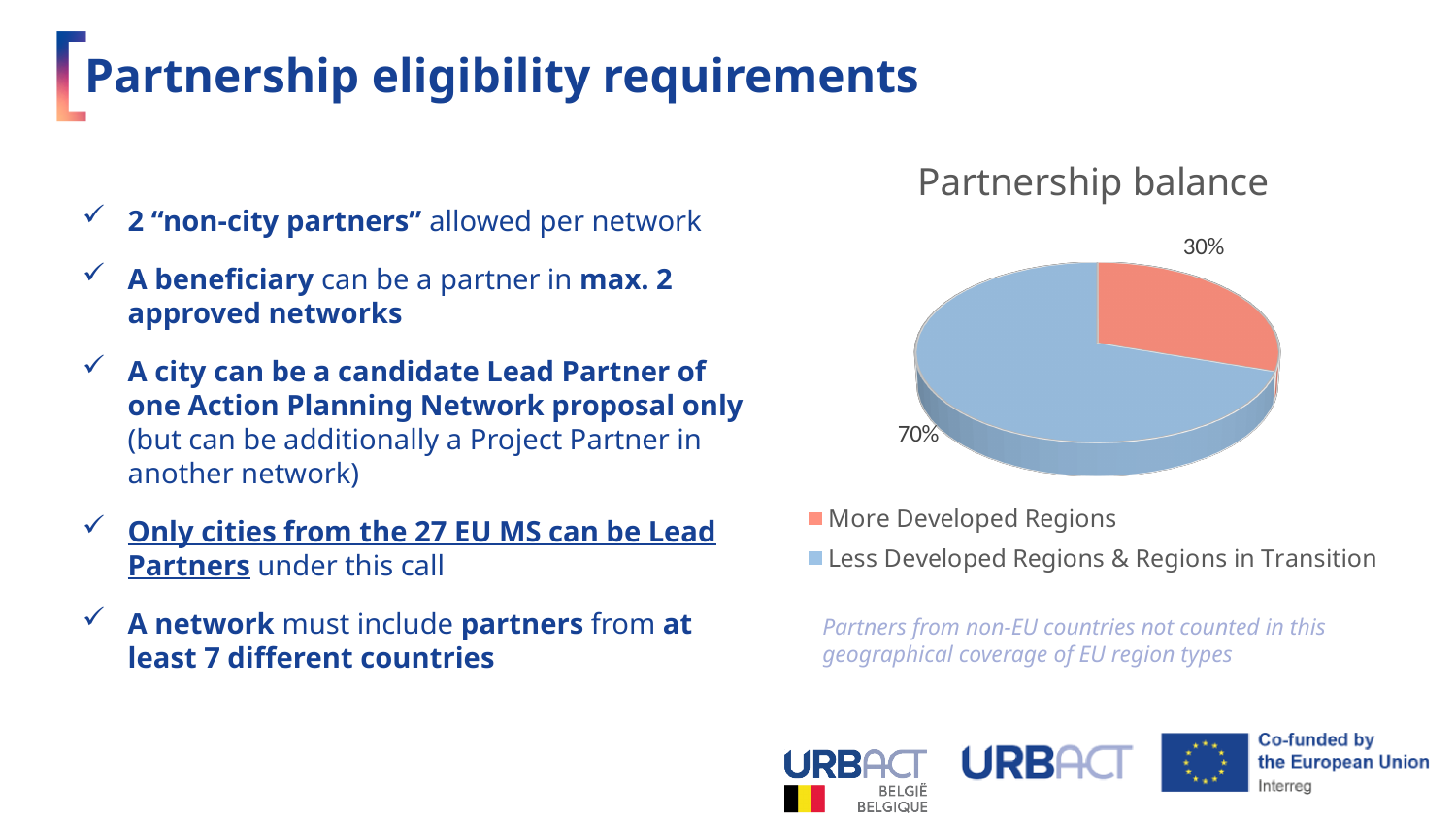
What kind of chart is shown on the slide? pie chart Which category has the smallest slice of the pie? More Developed Regions Which slice is larger: More Developed Regions or Less Developed Regions & Regions in Transition? Less Developed Regions & Regions in Transition What share of the pie is labelled for More Developed Regions? 30% What colour is the More Developed Regions slice in the pie chart? red/salmon Is the share for More Developed Regions greater or less than 50%? less What is the title of the chart on the slide? Partnership balance What is the difference in percentage points between the Less Developed Regions & Regions in Transition slice and the More Developed Regions slice? 40 percentage points Which category has the largest slice of the pie? Less Developed Regions & Regions in Transition What share of the pie is labelled for Less Developed Regions & Regions in Transition? 70% How many slices does the pie chart have? 2 How many entries does the chart legend list? 2